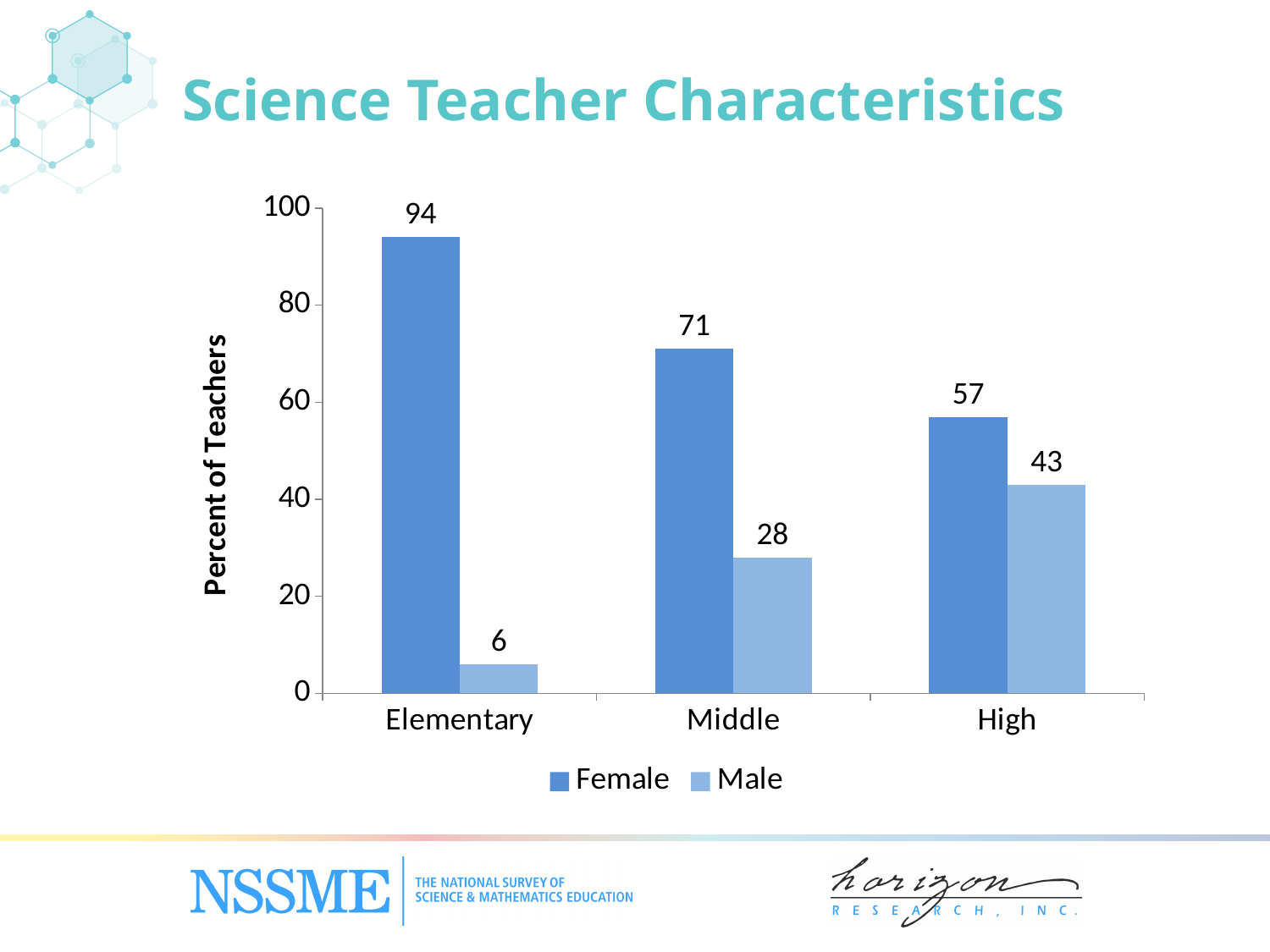
Which school level has the lowest Female value? High What is the difference between the Female values for Middle and High? 14 Do the Female values rise or fall from Elementary to High? Fall What is the Female value for Elementary? 94 Which is larger for High: the Female value or the Male value? Female What is the difference between the Female and Male values for Elementary? 88 Which school level has the highest Male value? High How many series does the legend list? 2 What is the Female value for High? 57 What is the Male value for Middle? 28 What kind of chart is shown on the slide? Bar chart How many school levels are shown on the x axis? 3